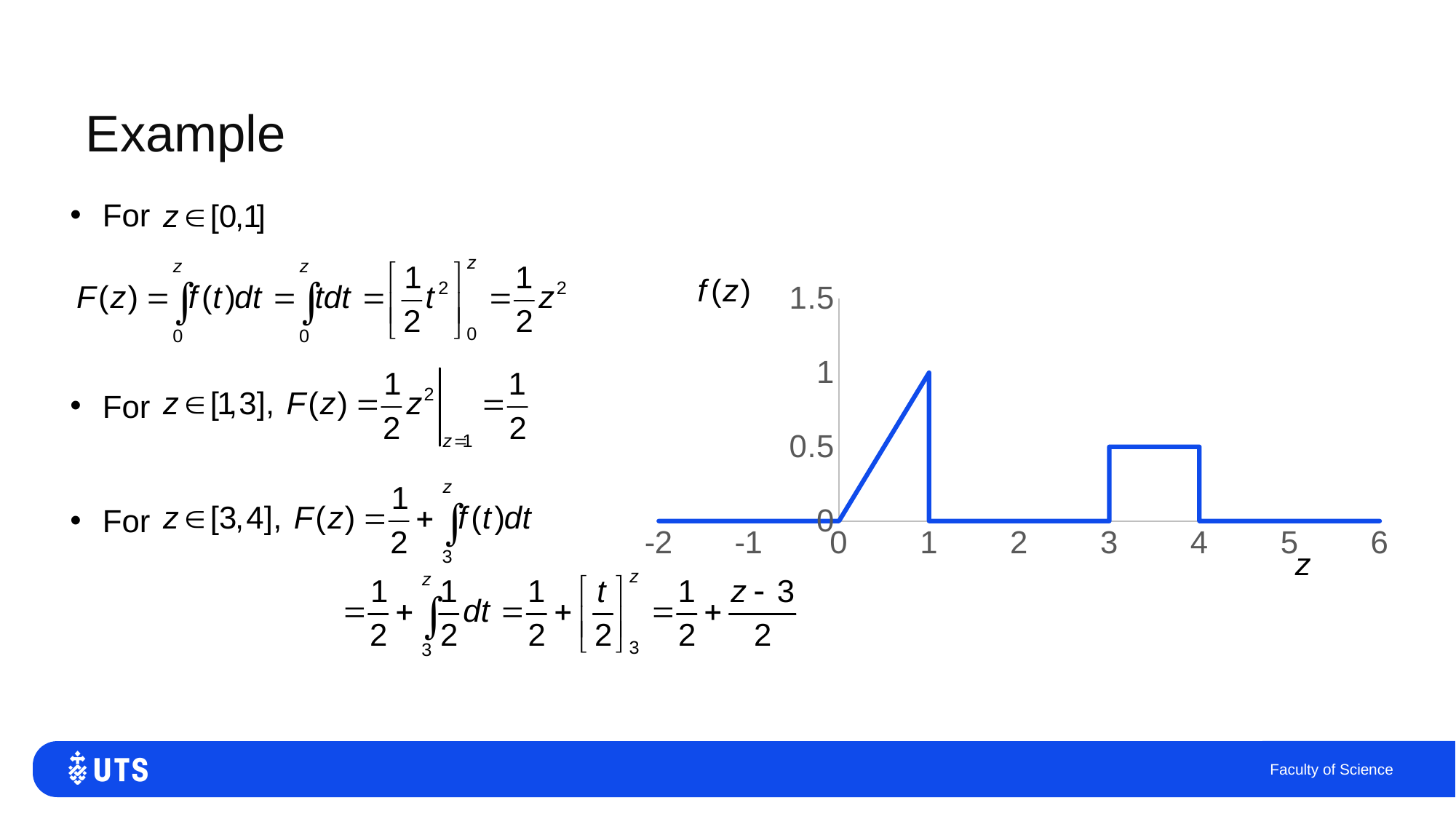
What is the maximum value reached by f(z) on the chart? 1 What kind of chart is shown on the slide? line chart Which is larger: the value of f(z) at z = 1 or the value of f(z) at z = 3.5? z = 1 At which value of z does f(z) reach its peak? 1 What is the label on the vertical axis of the chart? f(z) Does f(z) rise or fall as z goes from 0 to 1? rise Is the value of f(z) at z = 0.5 greater or less than 1? less What is the label on the horizontal axis of the chart? z What is the value of f(z) at z = -1? 0 What is the value of f(z) between z = 3 and z = 4? 0.5 What is the value of f(z) at z = 2? 0 What is the difference between the peak value of f(z) at z = 1 and the value of f(z) on the interval from 3 to 4? 0.5